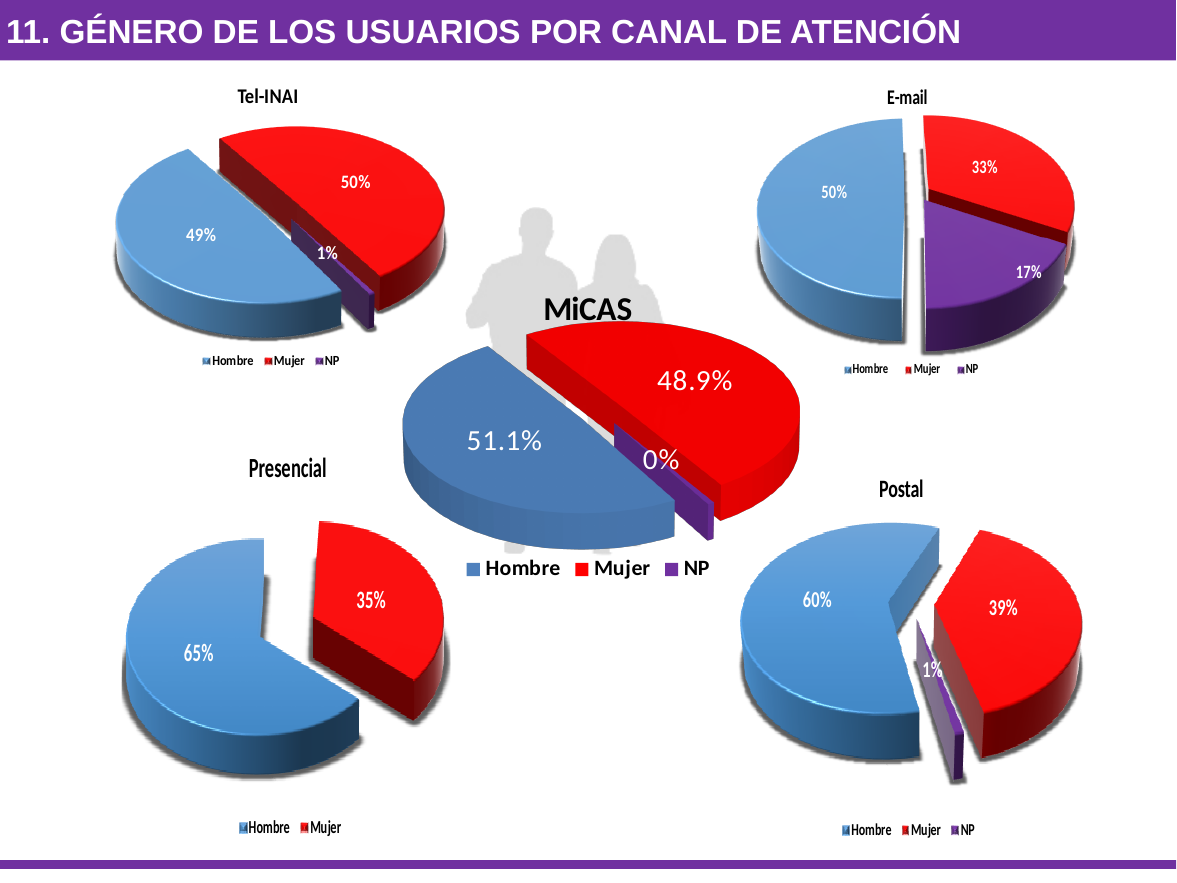
In the Presencial chart, what is the difference between Hombre and Mujer? 30% In the Postal chart, what is the value for Hombre? 60% In the Postal chart, which category has the smallest share? NP In the E-mail chart, what is the value for NP? 17% In the MiCAS chart, what is the value for Hombre? 51.1% In the Presencial chart, what is the value for Mujer? 35% What kind of chart is the Postal chart? Pie chart How many pie charts are shown on the slide? 5 In the E-mail chart, which category has the largest share? Hombre In the MiCAS chart, which is larger, Hombre or Mujer? Hombre In the Tel-INAI chart, what is the value for Mujer? 50% How many categories does the Presencial chart's legend list? 2